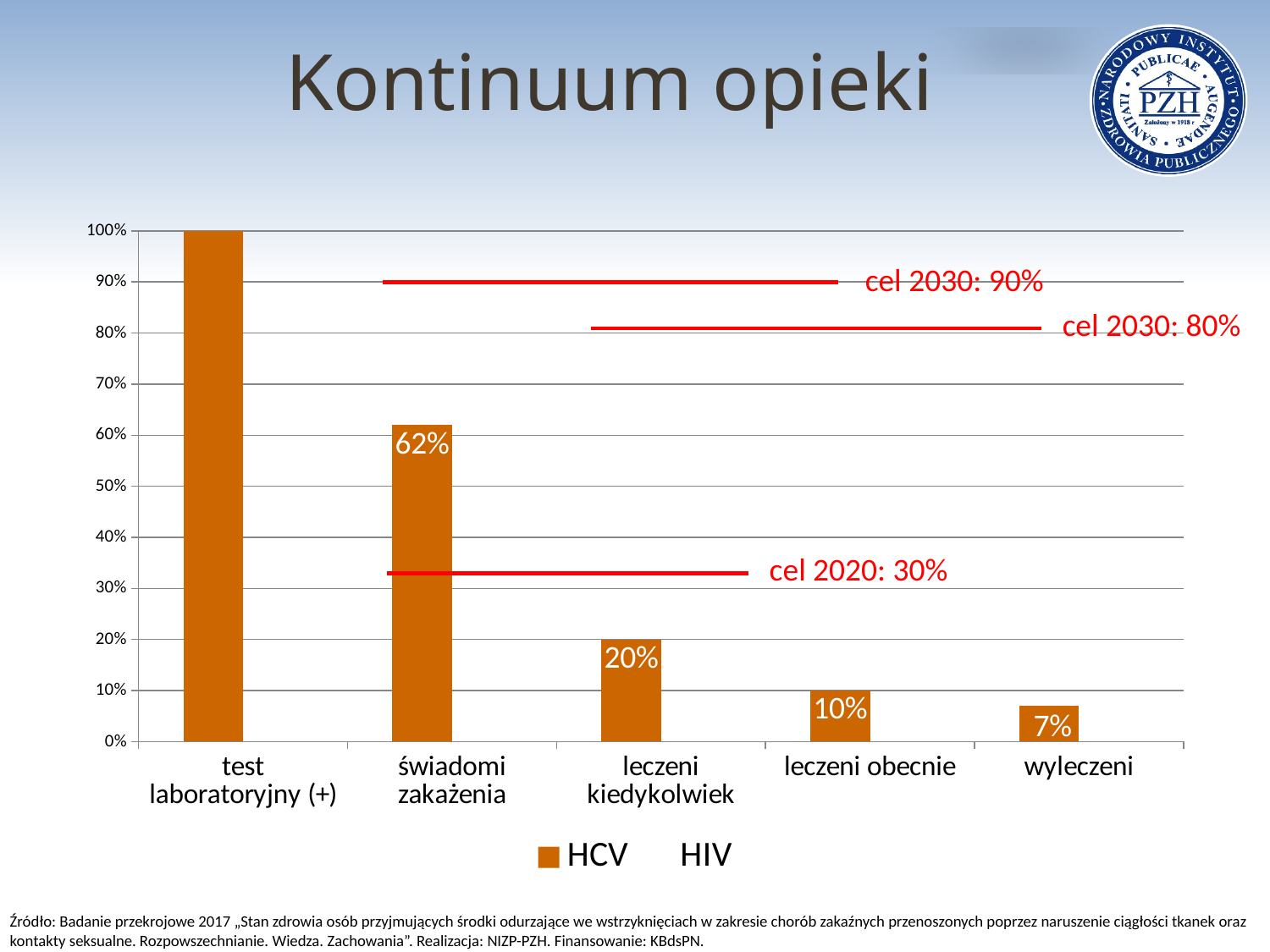
What is the difference between the HCV values for świadomi zakażenia and leczeni kiedykolwiek? 42% What is the HCV value for świadomi zakażenia? 62% Which category has the highest HCV bar? test laboratoryjny (+) What is the HCV value for wyleczeni? 7% How many categories are shown on the x axis? 5 Is the HCV value for świadomi zakażenia greater or less than 50%? greater How many series does the legend list? 2 Which is larger, the HCV value for leczeni obecnie or for wyleczeni? leczeni obecnie What kind of chart is shown on the slide? bar chart What is the HCV value for leczeni obecnie? 10% What is the HCV value for leczeni kiedykolwiek? 20% Which category has the lowest HCV bar? wyleczeni